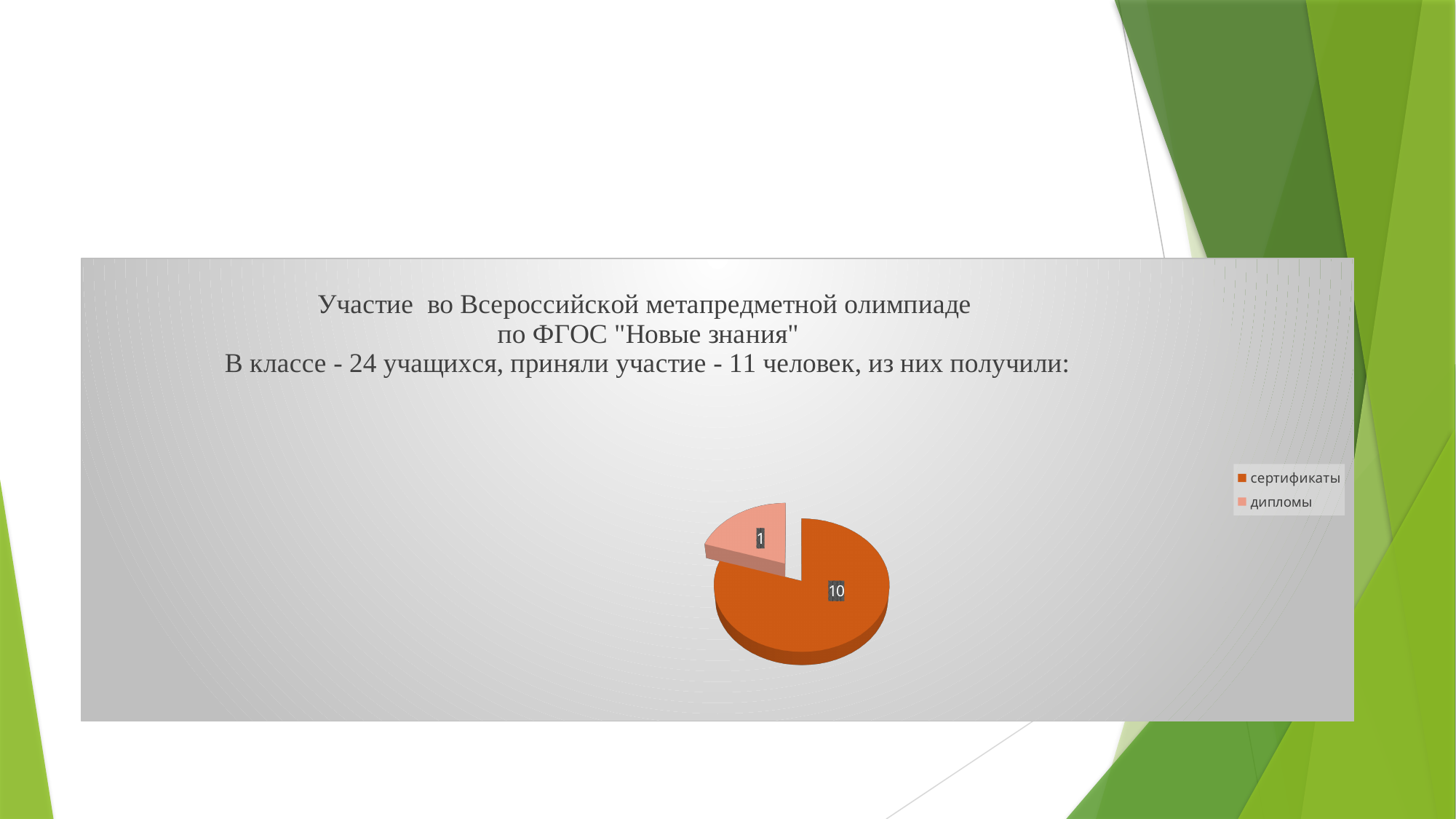
Which is larger, the value for сертификаты or the value for дипломы? сертификаты What is the total of the two slices in the pie chart? 11 What is the value for сертификаты? 10 Which legend entry is shown in the lighter pink colour? дипломы How many slices does the pie chart have? 2 What is the difference between the values for сертификаты and дипломы? 9 What kind of chart is shown on the slide? pie chart Which category has the smallest slice of the pie? дипломы Which category has the largest slice of the pie? сертификаты What is the value for дипломы? 1 How many entries does the legend list? 2 According to the text above the chart, how many people took part in the olympiad? 11